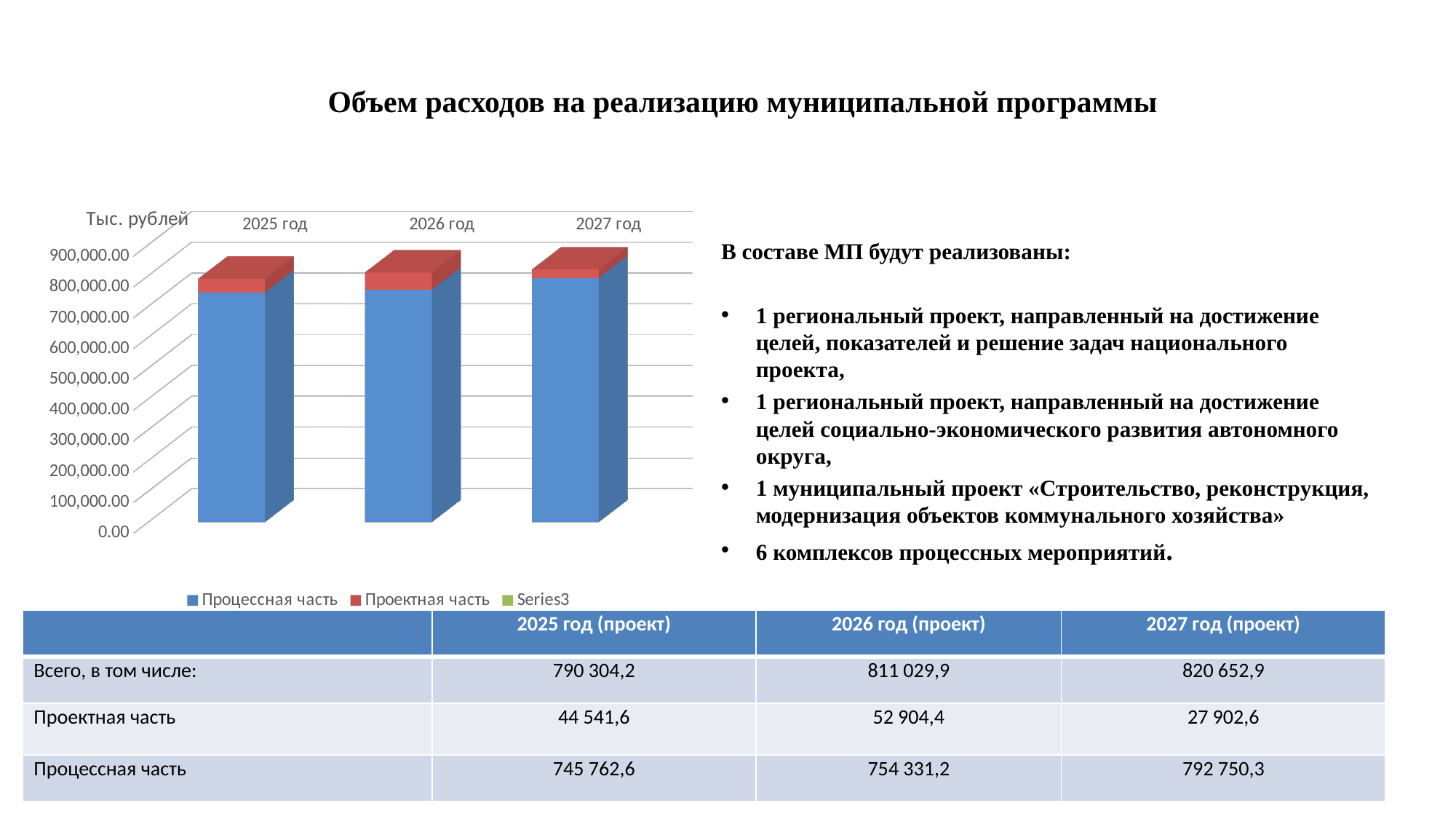
What kind of chart is shown on the slide? bar chart Which year has the tallest stacked bar in total? 2027 год What unit label is shown at the top of the chart's vertical axis? Тыс. рублей Which year has the shortest stacked bar in total? 2025 год Which is larger, the Процессная часть segment for 2027 год or for 2025 год? 2027 год Do the total bar heights rise or fall from 2025 год to 2027 год? rise How many year categories are plotted on the chart? 3 Is the value of Процессная часть for 2025 год greater or less than 700,000.00? greater Is the total height of the stacked bar for 2027 год greater or less than 900,000.00? less What is the third entry in the chart legend? Series3 Which year has the smallest Проектная часть segment? 2027 год How many series does the chart legend list? 3